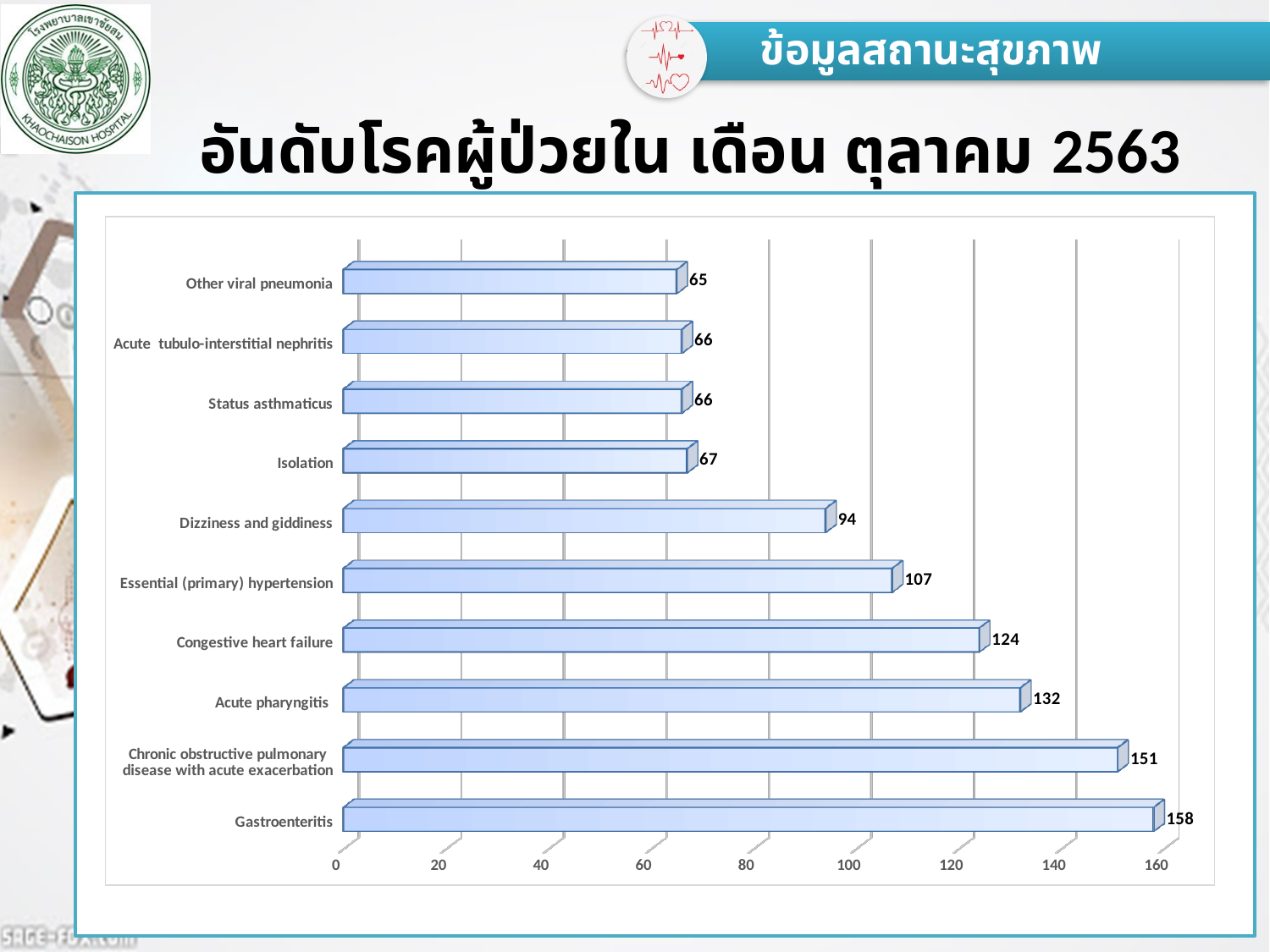
What is the value for Dizziness and giddiness? 94 Is the value for Essential (primary) hypertension greater or less than 100? greater What is the value for Gastroenteritis? 158 What is the value for Congestive heart failure? 124 Which category has the lowest value? Other viral pneumonia What is the maximum value shown on the horizontal axis? 160 How many categories are shown in the chart? 10 Which category has the highest value? Gastroenteritis What is the difference between Gastroenteritis and Chronic obstructive pulmonary disease with acute exacerbation? 7 What kind of chart is shown on the slide? Bar chart Which is larger, Acute pharyngitis or Congestive heart failure? Acute pharyngitis What is the difference between Acute pharyngitis and Essential (primary) hypertension? 25